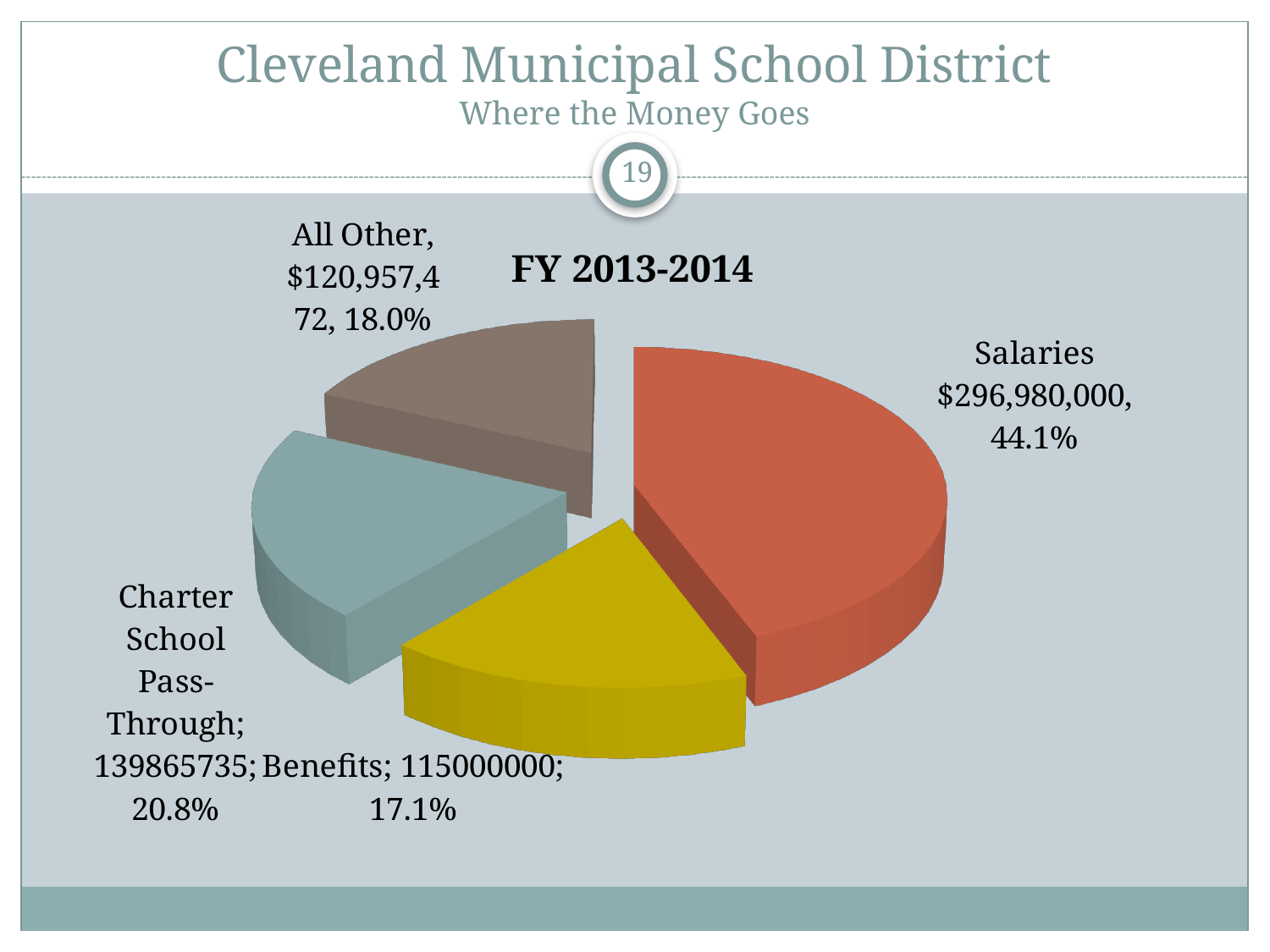
What percentage of the pie is Salaries? 44.1% What kind of chart is shown on the slide? Pie chart What percentage of the pie is Charter School Pass-Through? 20.8% What percentage of the pie is All Other? 18.0% Which category has the largest share of the pie? Salaries How many slices does the pie chart have? 4 Which is larger, the share for Charter School Pass-Through or the share for All Other? Charter School Pass-Through What is the difference in percentage points between the Salaries share and the Benefits share? 27.0 percentage points What is the title of the pie chart? FY 2013-2014 What value is shown for Benefits? 115000000 What is the dollar value shown for Salaries? $296,980,000 Which category has the smallest share of the pie? Benefits